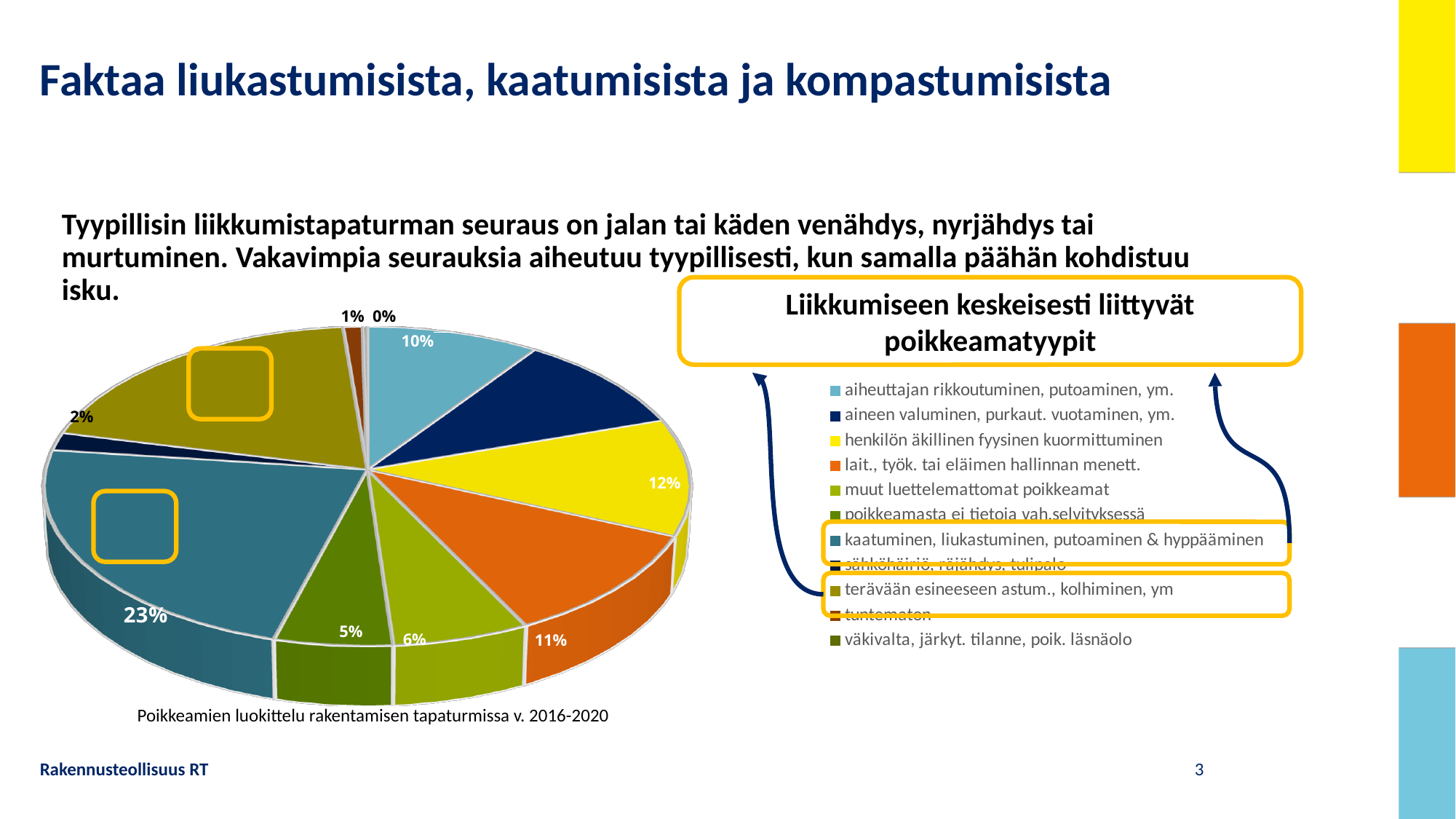
What percentage is shown for tuntematon? 1% What is the caption printed below the pie chart? Poikkeamien luokittelu rakentamisen tapaturmissa v. 2016-2020 Which category has the largest share of the pie? kaatuminen, liukastuminen, putoaminen & hyppääminen What percentage is shown for muut luettelemattomat poikkeamat? 6% How many categories does the legend list? 11 What percentage is shown for henkilön äkillinen fyysinen kuormittuminen? 12% What percentage is shown for aiheuttajan rikkoutuminen, putoaminen, ym.? 10% What is the difference in percentage points between kaatuminen, liukastuminen, putoaminen & hyppääminen and henkilön äkillinen fyysinen kuormittuminen? 11 percentage points Which category has the smallest share of the pie? väkivalta, järkyt. tilanne, poik. läsnäolo What percentage is shown for kaatuminen, liukastuminen, putoaminen & hyppääminen? 23% What kind of chart is shown on the slide? pie chart What percentage is shown for lait., työk. tai eläimen hallinnan menett.? 11%